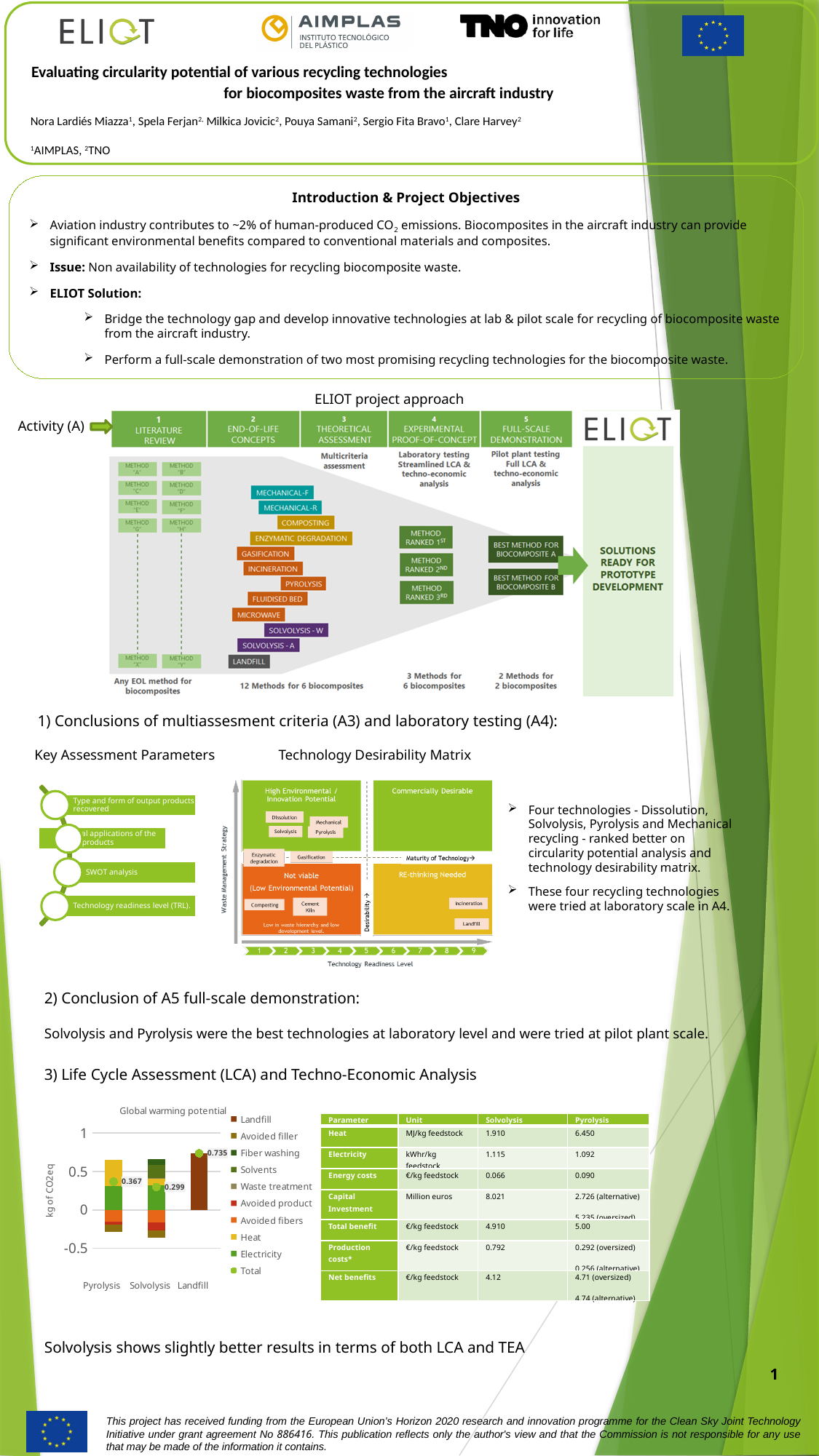
Which category has the lowest Total in the Global warming potential chart? Solvolysis How many categories are shown on the x axis of the Global warming potential chart? 3 What is the Total value for Landfill in the Global warming potential chart? 0.735 What is the Total value for Pyrolysis in the Global warming potential chart? 0.367 In the Global warming potential chart, is the Total for Landfill greater or less than 0.5? greater How many entries does the legend of the Global warming potential chart list? 10 In the Global warming potential chart, is the Total for Pyrolysis or for Solvolysis larger? Pyrolysis Which category has the highest Total in the Global warming potential chart? Landfill What is the y-axis label of the Global warming potential chart? kg of CO2eq What is the difference between the Total for Pyrolysis and the Total for Solvolysis in the Global warming potential chart? 0.068 What is the Total value for Solvolysis in the Global warming potential chart? 0.299 What is the difference between the Total for Landfill and the Total for Pyrolysis in the Global warming potential chart? 0.368